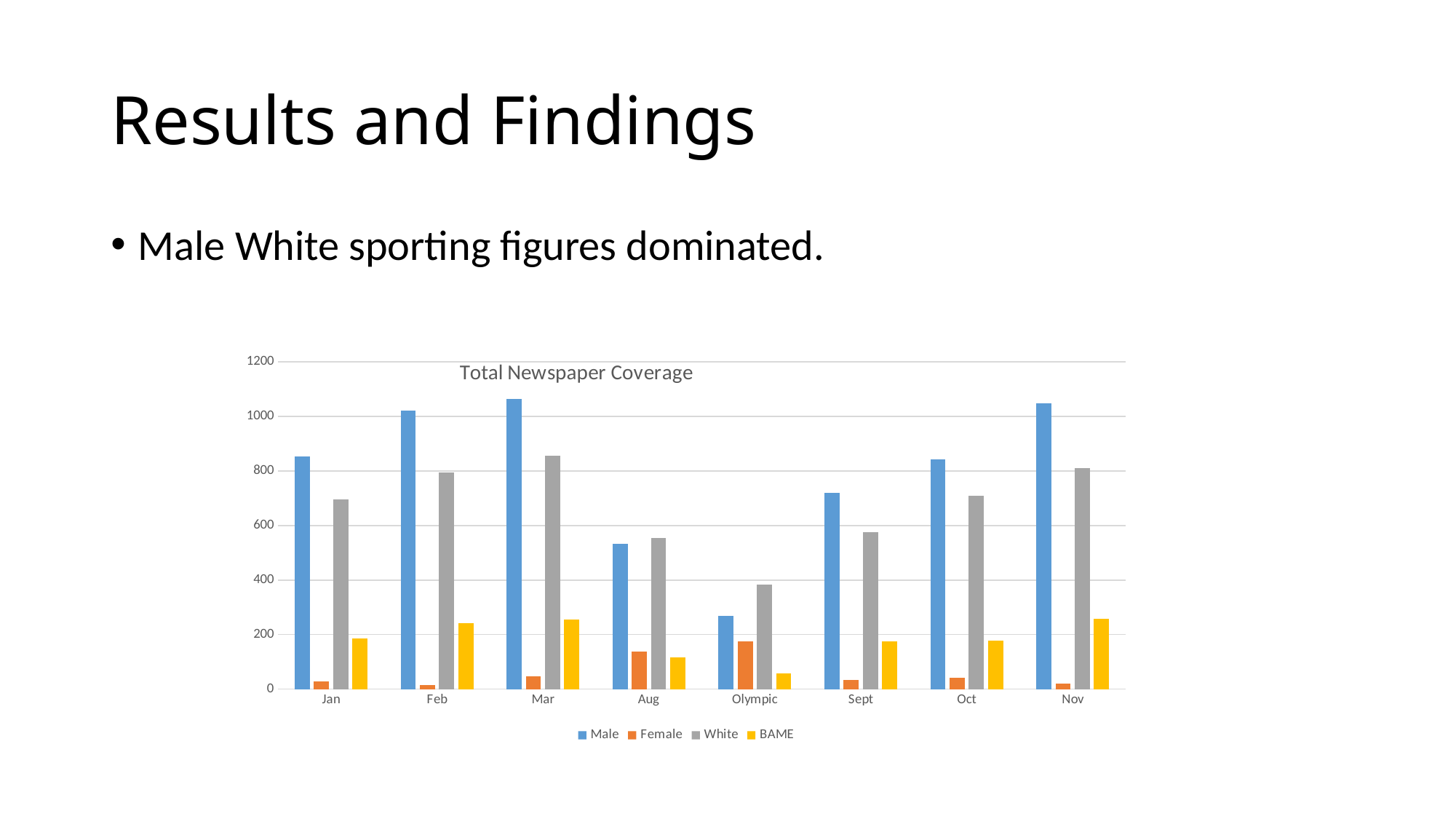
What kind of chart is shown on the slide? bar chart How many categories are shown on the x axis? 8 Which category has the lowest BAME value? Olympic Is the Male value for Jan greater or less than 800? greater What is the title of the chart? Total Newspaper Coverage How many series does the legend list? 4 Is the White value for Olympic greater or less than 400? less Which category has the highest Female value? Olympic Which category has the highest White value? Mar In Jan, which is larger, the Male value or the White value? Male In Olympic, which is larger, the Female value or the BAME value? Female Which category has the lowest Male value? Olympic